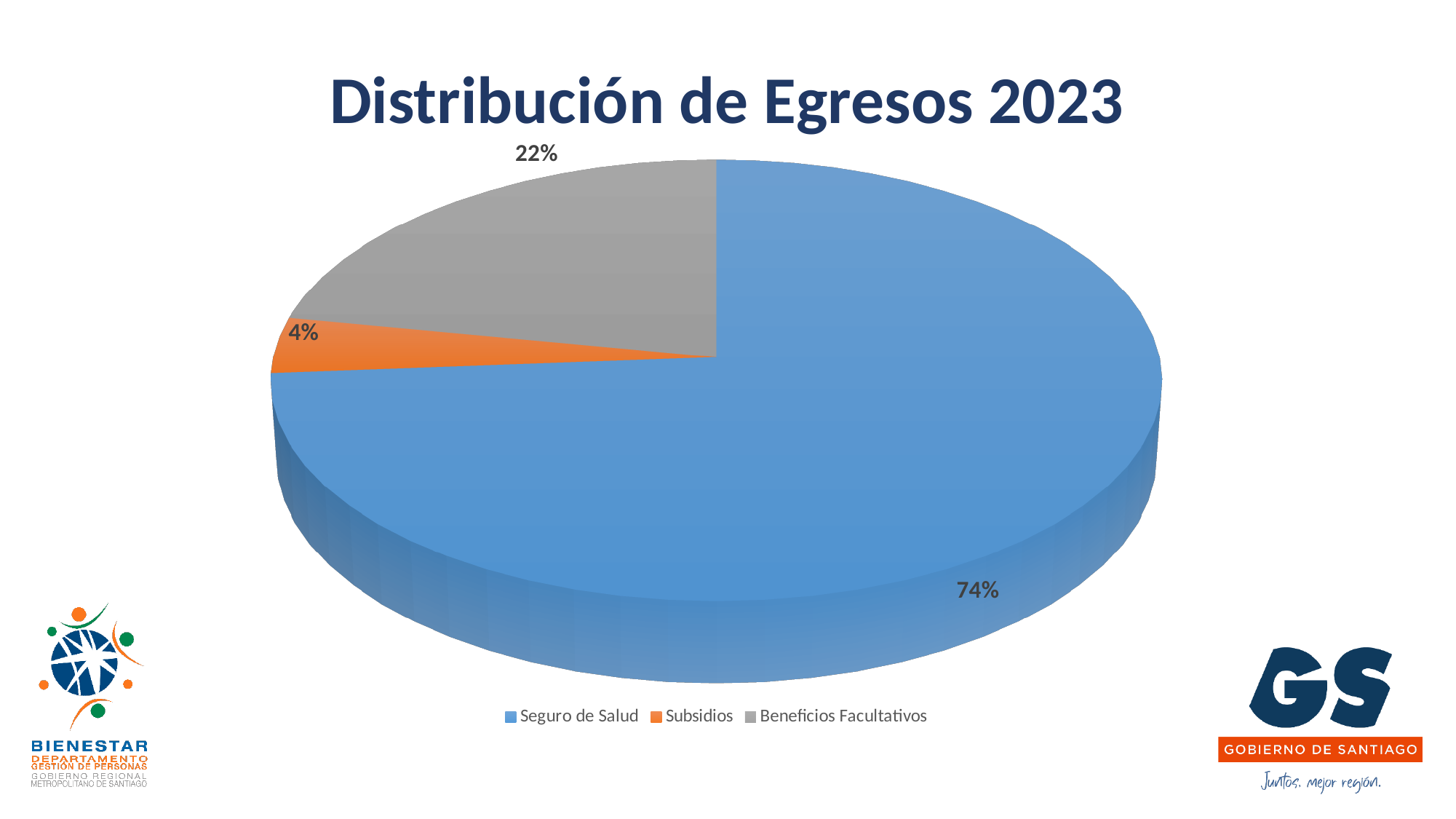
What share of the pie does Subsidios represent? 4% What is the title of the chart? Distribución de Egresos 2023 Which is larger, the share for Beneficios Facultativos or the share for Subsidios? Beneficios Facultativos Which category has the smallest slice of the pie? Subsidios What is the difference in percentage points between Seguro de Salud and Beneficios Facultativos? 52 What kind of chart is shown on the slide? Pie chart Which category has the largest slice of the pie? Seguro de Salud What is the difference in percentage points between Beneficios Facultativos and Subsidios? 18 How many categories are shown in the pie chart? 3 Which colour represents Subsidios in the chart? Orange What share of the pie does Beneficios Facultativos represent? 22% What share of the pie does Seguro de Salud represent? 74%